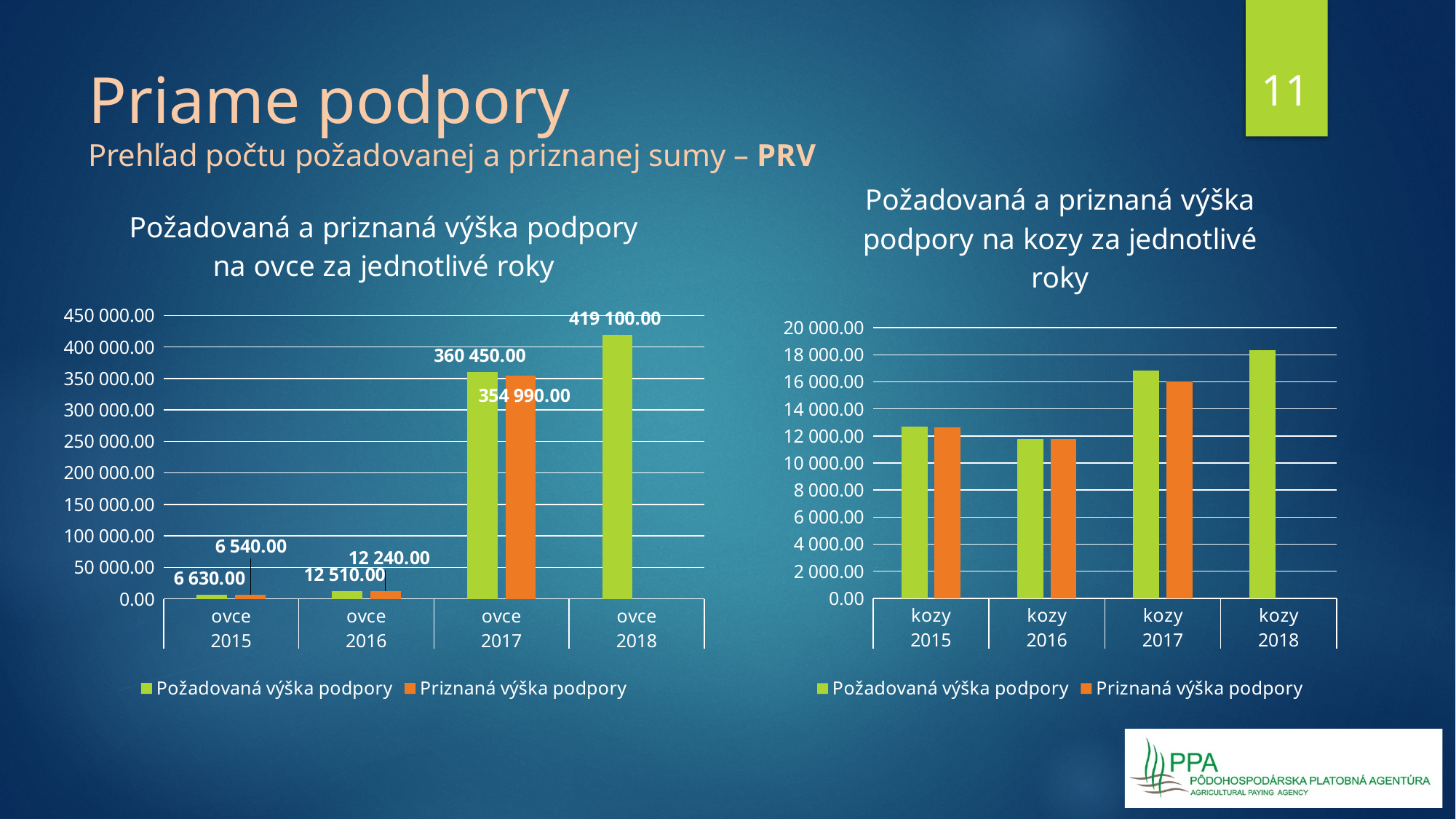
In the left chart (ovce), which is larger: the Požadovaná výška podpory for ovce 2017 or for ovce 2018? ovce 2018 In the left chart (ovce), what is the difference between the Požadovaná and Priznaná výška podpory for ovce 2017? 5 460.00 In the left chart (ovce), which year has the highest Požadovaná výška podpory? ovce 2018 In the left chart (ovce), what is the difference between the Požadovaná and Priznaná výška podpory for ovce 2015? 90.00 In the left chart (ovce), what is the Požadovaná výška podpory for ovce 2017? 360 450.00 How many series does the legend of the right chart (kozy) list? 2 In the left chart (ovce), what is the Priznaná výška podpory for ovce 2016? 12 240.00 In the right chart (kozy), which year has the highest Požadovaná výška podpory? kozy 2018 In the right chart (kozy), is the Priznaná výška podpory for kozy 2016 greater or less than 14 000.00? less What kind of chart is the left chart (ovce)? bar chart In the right chart (kozy), is the Požadovaná výška podpory for kozy 2018 greater or less than 16 000.00? greater In the right chart (kozy), which year has the lowest Požadovaná výška podpory? kozy 2016